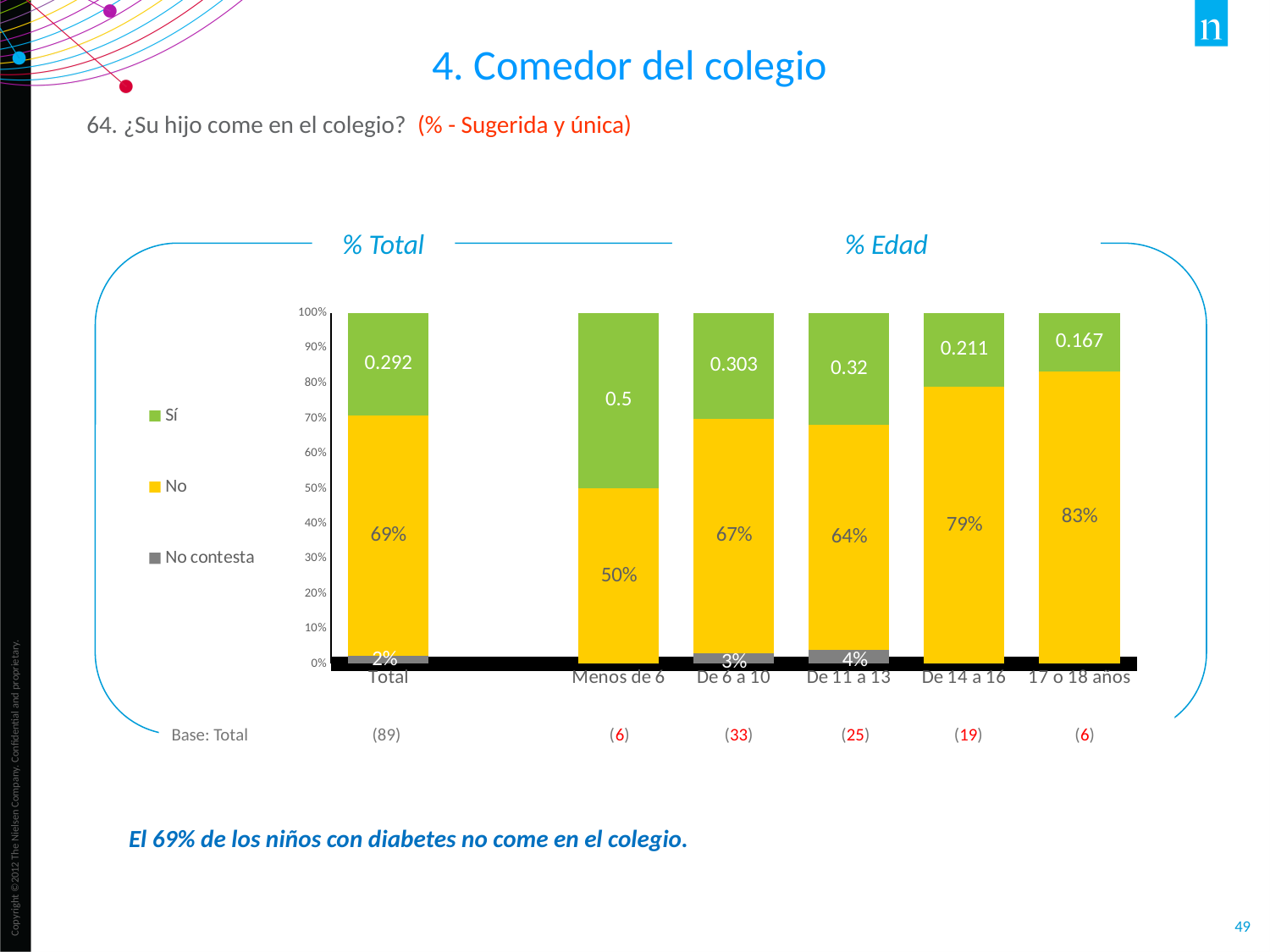
Which category has the highest value for the "No" series? 17 o 18 años What kind of chart is shown on the slide? Stacked bar chart How many series does the legend list? 3 What is the value of the "Sí" series for the "De 14 a 16" category? 0.211 Which is larger: the "Sí" value for "De 6 a 10" or for "De 11 a 13"? De 11 a 13 What is the value of the "Sí" series for the "Menos de 6" category? 0.5 How many categories are shown on the x axis of the chart? 6 Which category has the lowest value for the "No" series? Menos de 6 What is the value of the "No contesta" series for the "De 11 a 13" category? 4% What is the value of the "No" series for the "17 o 18 años" category? 83% What is the value of the "No" series for the "Total" category? 69% What is the difference between the "No" values for "De 14 a 16" and "De 6 a 10"? 12%